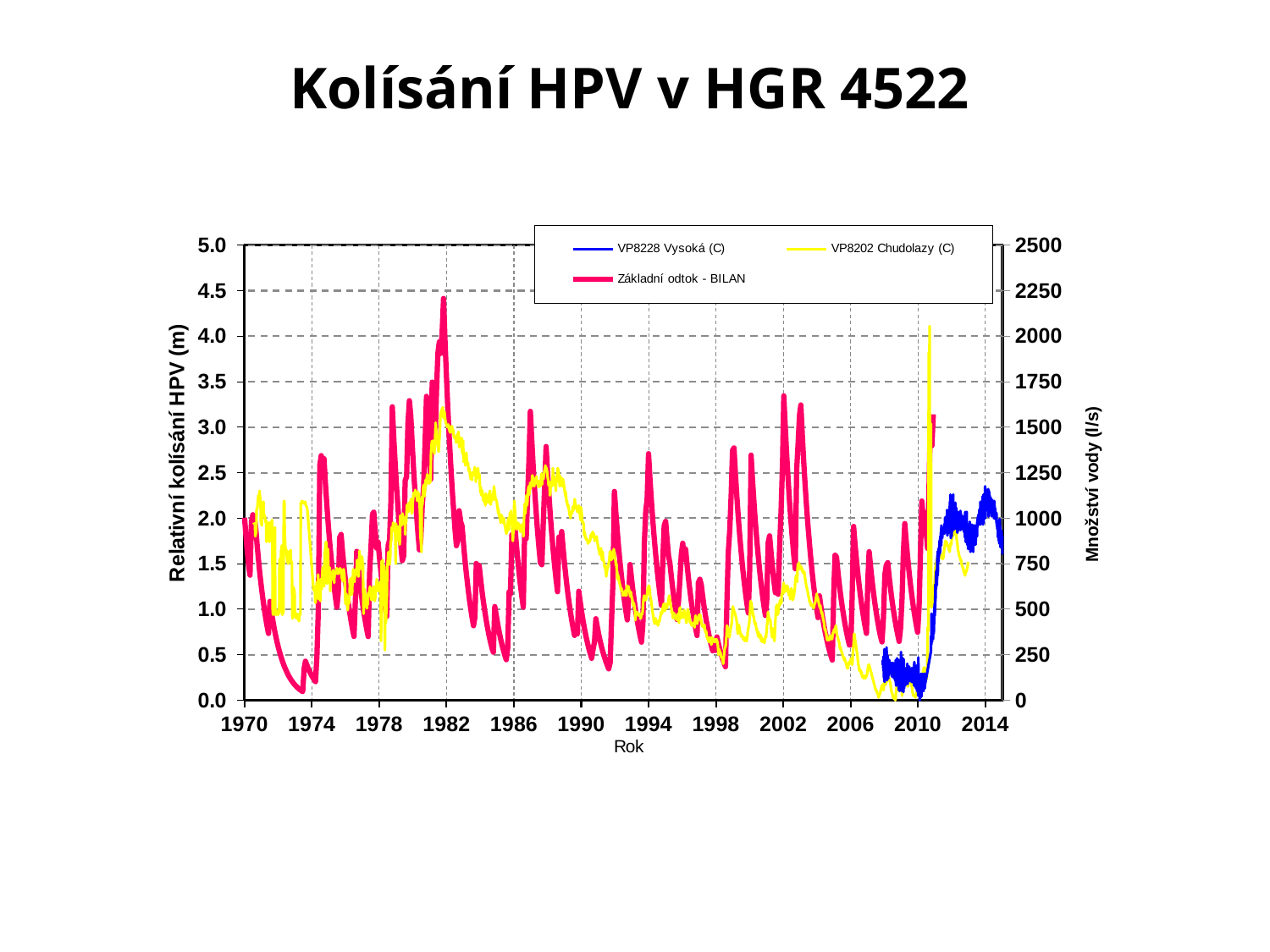
Is the value of the VP8228 Vysoká (C) series around 2013 greater or less than 1.5 on the left axis? greater What is the highest value shown on the right-hand axis (Množství vody)? 2500 What is the label of the x axis? Rok What is the last year labelled on the x axis? 2014 What kind of chart is shown on the slide? line chart Is the value of the VP8228 Vysoká (C) series around 2009 greater or less than 1.0 on the left axis? less Is the value of the Základní odtok - BILAN series around 1973 greater or less than 0.5 on the left axis? less What is the title of the chart? Kolísání HPV v HGR 4522 How many series does the legend list? 3 What is the first year shown on the x axis? 1970